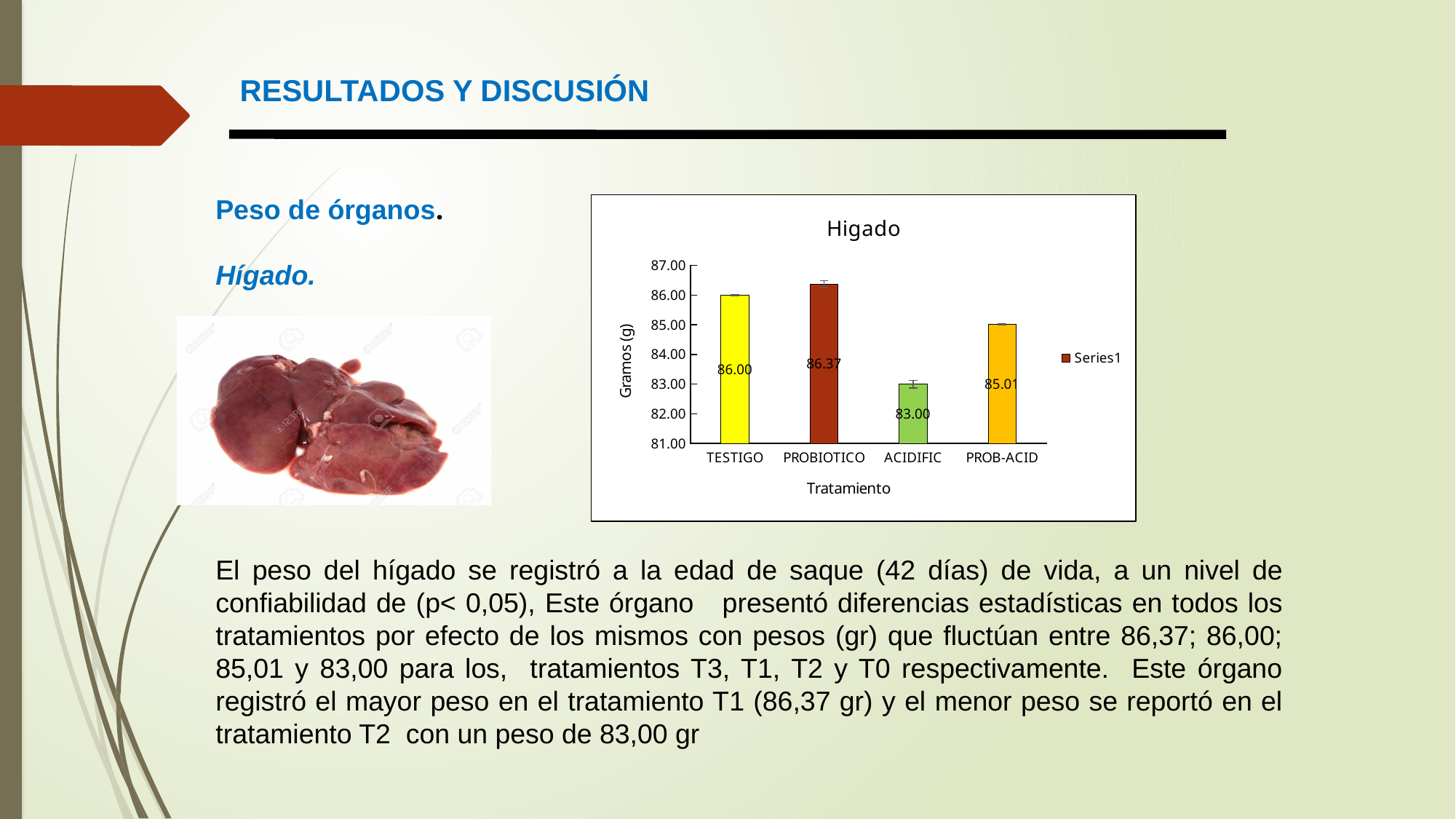
Which is larger in the Higado chart, TESTIGO or PROB-ACID? TESTIGO What is the value for PROB-ACID in the Higado chart? 85.01 What is the value for PROBIOTICO in the Higado chart? 86.37 Which treatment has the lowest value in the Higado chart? ACIDIFIC What kind of chart is the Higado chart? bar chart What is the value for TESTIGO in the Higado chart? 86.00 How many treatments are shown on the x axis of the Higado chart? 4 Is the value for ACIDIFIC in the Higado chart greater or less than 84.00? less Which treatment has the highest value in the Higado chart? PROBIOTICO What is the value for ACIDIFIC in the Higado chart? 83.00 What is the y-axis label of the Higado chart? Gramos (g) What is the difference between the PROBIOTICO and ACIDIFIC values in the Higado chart? 3.37